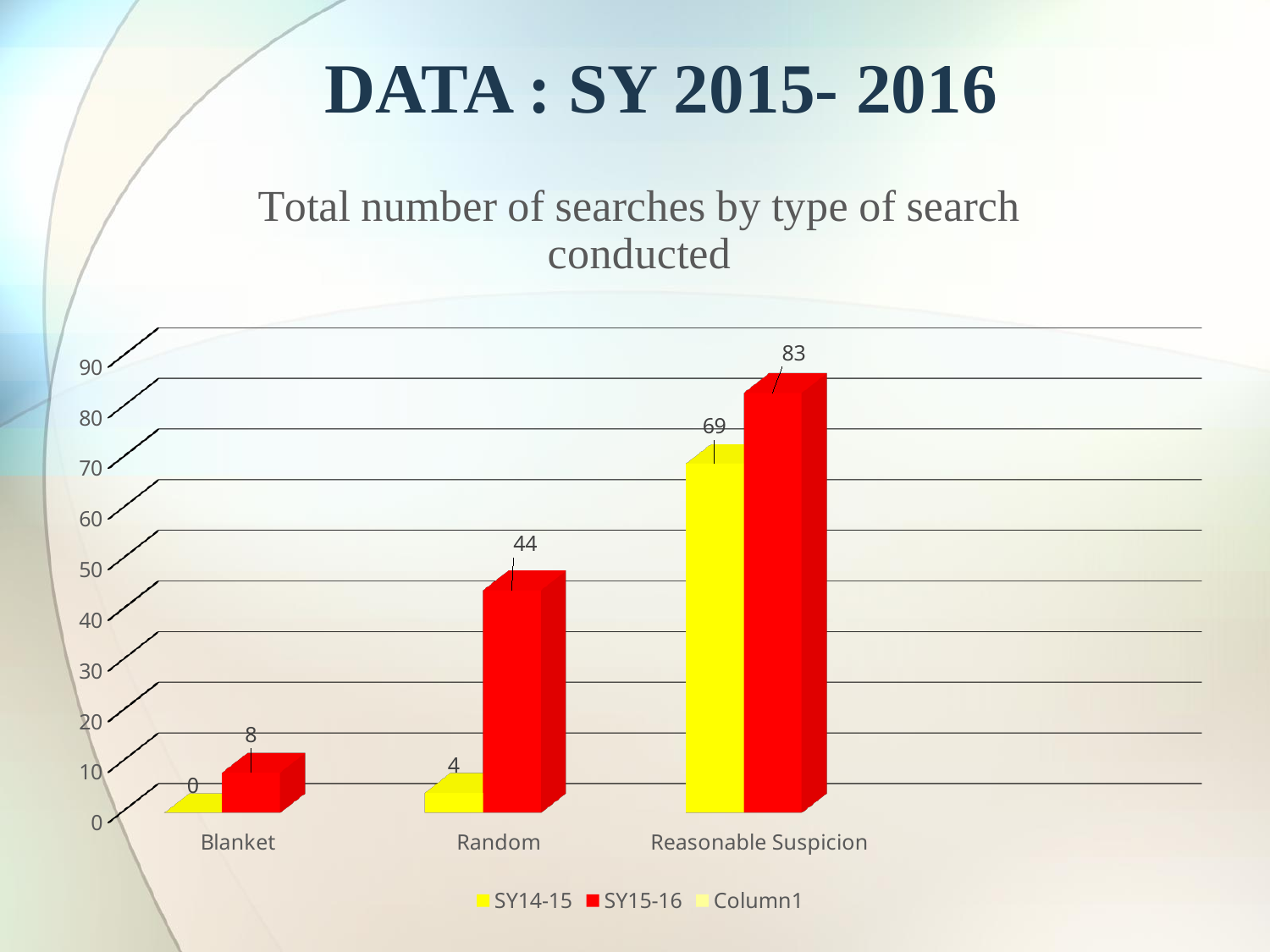
Which category has the lowest value in the SY14-15 series? Blanket What is the difference between the SY15-16 and SY14-15 values for Reasonable Suspicion? 14 How many categories are shown on the x axis? 3 Which is larger for Random: the SY14-15 value or the SY15-16 value? SY15-16 What is the value for Blanket in the SY14-15 series? 0 What is the value for Reasonable Suspicion in the SY15-16 series? 83 What is the value for Random in the SY14-15 series? 4 What is the value for Blanket in the SY15-16 series? 8 Which category has the highest value in the SY15-16 series? Reasonable Suspicion What kind of chart is shown on the slide? Bar chart What is the difference between the SY15-16 and SY14-15 values for Random? 40 How many series does the legend list? 3